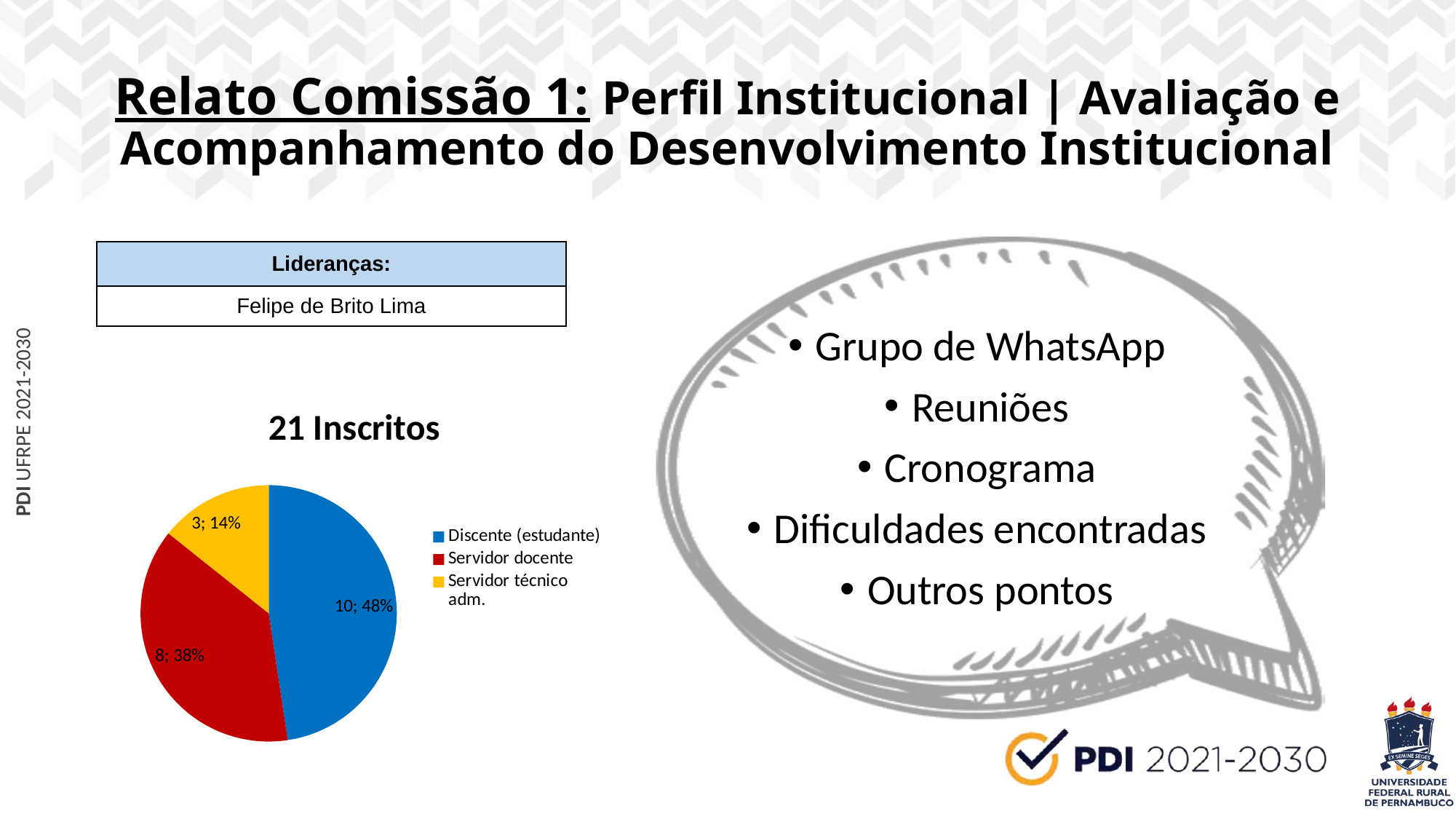
Which category has the smallest slice of the pie? Servidor técnico adm. How many entries does the legend of the pie chart list? 3 What kind of chart is shown on the slide? Pie chart How many slices does the pie chart have? 3 What is the title of the pie chart? 21 Inscritos Which category has the largest slice of the pie? Discente (estudante) How many inscritos are in the Servidor técnico adm. category? 3 How many inscritos are in the Discente (estudante) category? 10 What is the difference in count between Discente (estudante) and Servidor docente? 2 What percentage of the pie does Servidor docente represent? 38% Which has more inscritos, Servidor docente or Servidor técnico adm.? Servidor docente What colour is the Servidor técnico adm. slice? Yellow